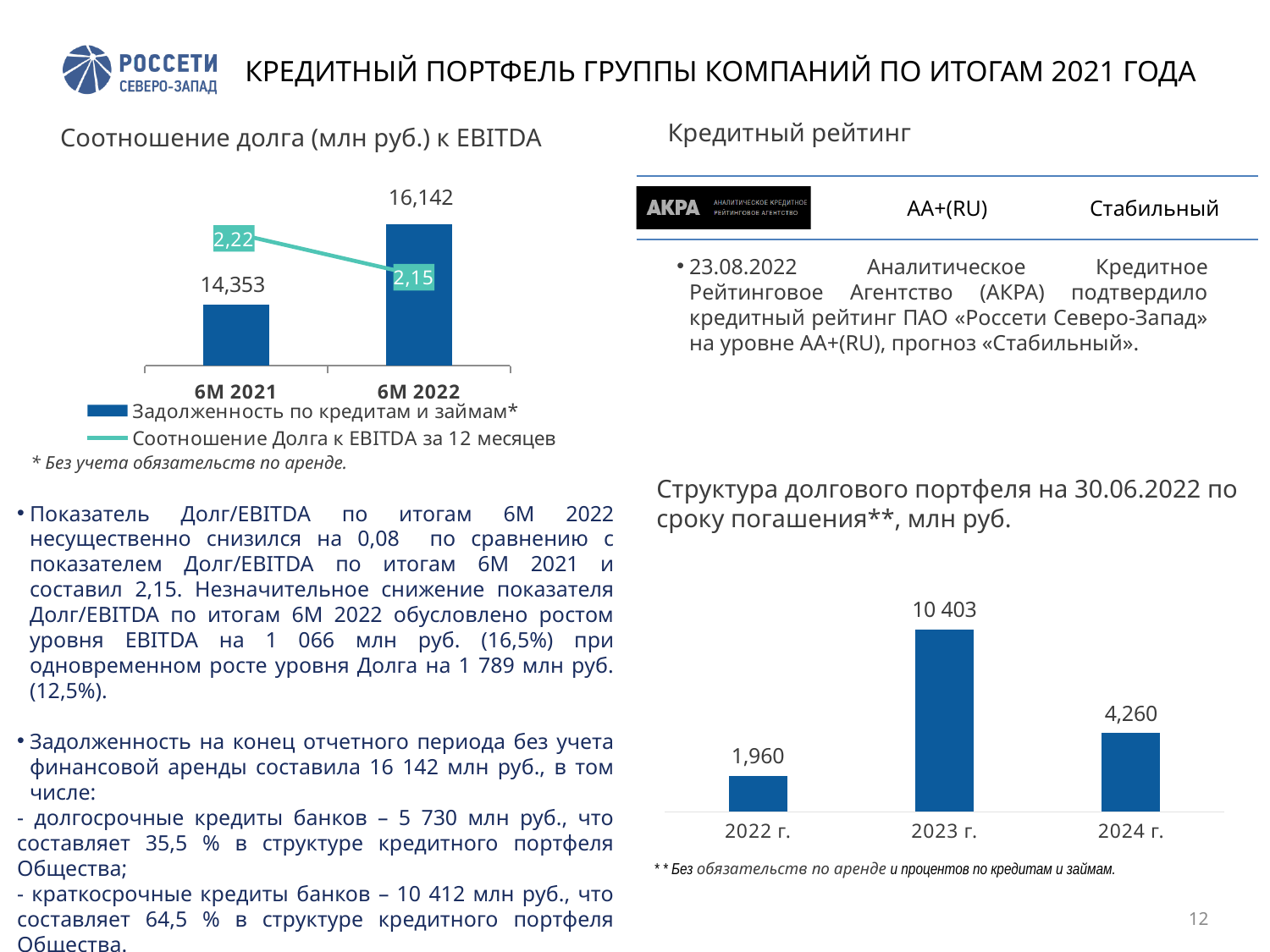
In the chart 'Структура долгового портфеля на 30.06.2022 по сроку погашения**, млн руб.', what is the value for 2022 г.? 1,960 In the chart 'Соотношение долга (млн руб.) к EBITDA', by how much did 'Задолженность по кредитам и займам*' increase from 6M 2021 to 6M 2022? 1,789 In the chart 'Структура долгового портфеля на 30.06.2022 по сроку погашения**, млн руб.', which year has the highest value? 2023 г. How many series does the legend of the chart 'Соотношение долга (млн руб.) к EBITDA' list? 2 In the chart 'Соотношение долга (млн руб.) к EBITDA', what is the 'Соотношение Долга к EBITDA за 12 месяцев' for 6M 2021? 2,22 In the chart 'Соотношение долга (млн руб.) к EBITDA', what is the value of 'Задолженность по кредитам и займам*' for 6M 2022? 16,142 In the chart 'Структура долгового портфеля на 30.06.2022 по сроку погашения**, млн руб.', what is the value for 2023 г.? 10 403 What type of chart is 'Структура долгового портфеля на 30.06.2022 по сроку погашения**, млн руб.'? bar chart In the chart 'Соотношение долга (млн руб.) к EBITDA', does the debt-to-EBITDA ratio line rise or fall from 6M 2021 to 6M 2022? fall In the chart 'Соотношение долга (млн руб.) к EBITDA', what is the value of 'Задолженность по кредитам и займам*' for 6M 2021? 14,353 In the chart 'Структура долгового портфеля на 30.06.2022 по сроку погашения**, млн руб.', which year has the lowest value? 2022 г. In the chart 'Соотношение долга (млн руб.) к EBITDA', what is the 'Соотношение Долга к EBITDA за 12 месяцев' for 6M 2022? 2,15